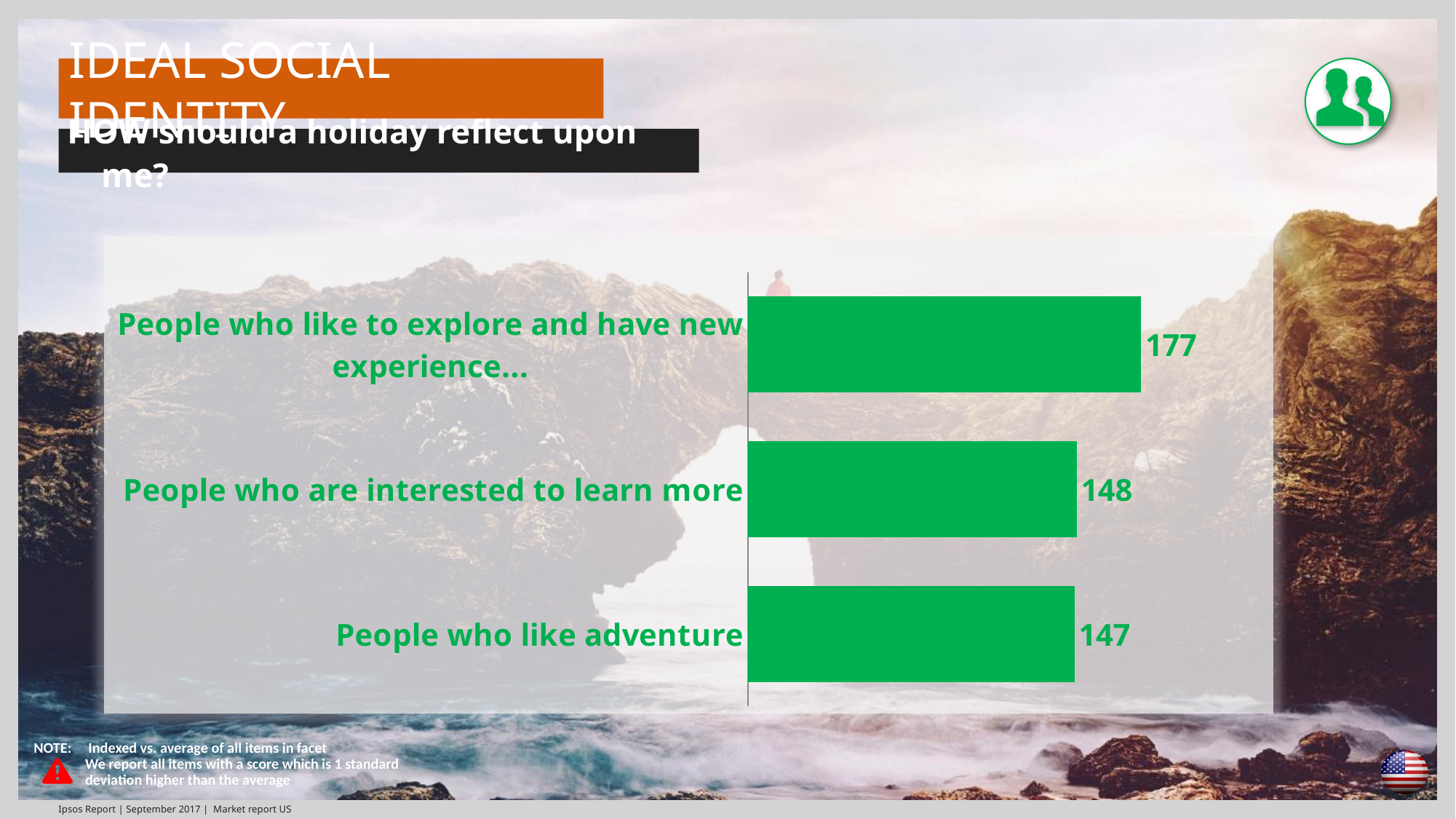
What is the value for "People who like adventure"? 147 What is the value for "People who are interested to learn more"? 148 Which is larger: the value for "People who like to explore and have new experience..." or the value for "People who like adventure"? People who like to explore and have new experience... Which category has the lowest value? People who like adventure What is the difference between the values for "People who like to explore and have new experience..." and "People who are interested to learn more"? 29 What is the difference between the values for "People who like to explore and have new experience..." and "People who like adventure"? 30 What kind of chart is shown on the slide? Bar chart What is the difference between the values for "People who are interested to learn more" and "People who like adventure"? 1 What colour are the bars in the chart? Green Which category has the highest value? People who like to explore and have new experience... What is the value for "People who like to explore and have new experience..."? 177 How many categories are shown in the chart? 3